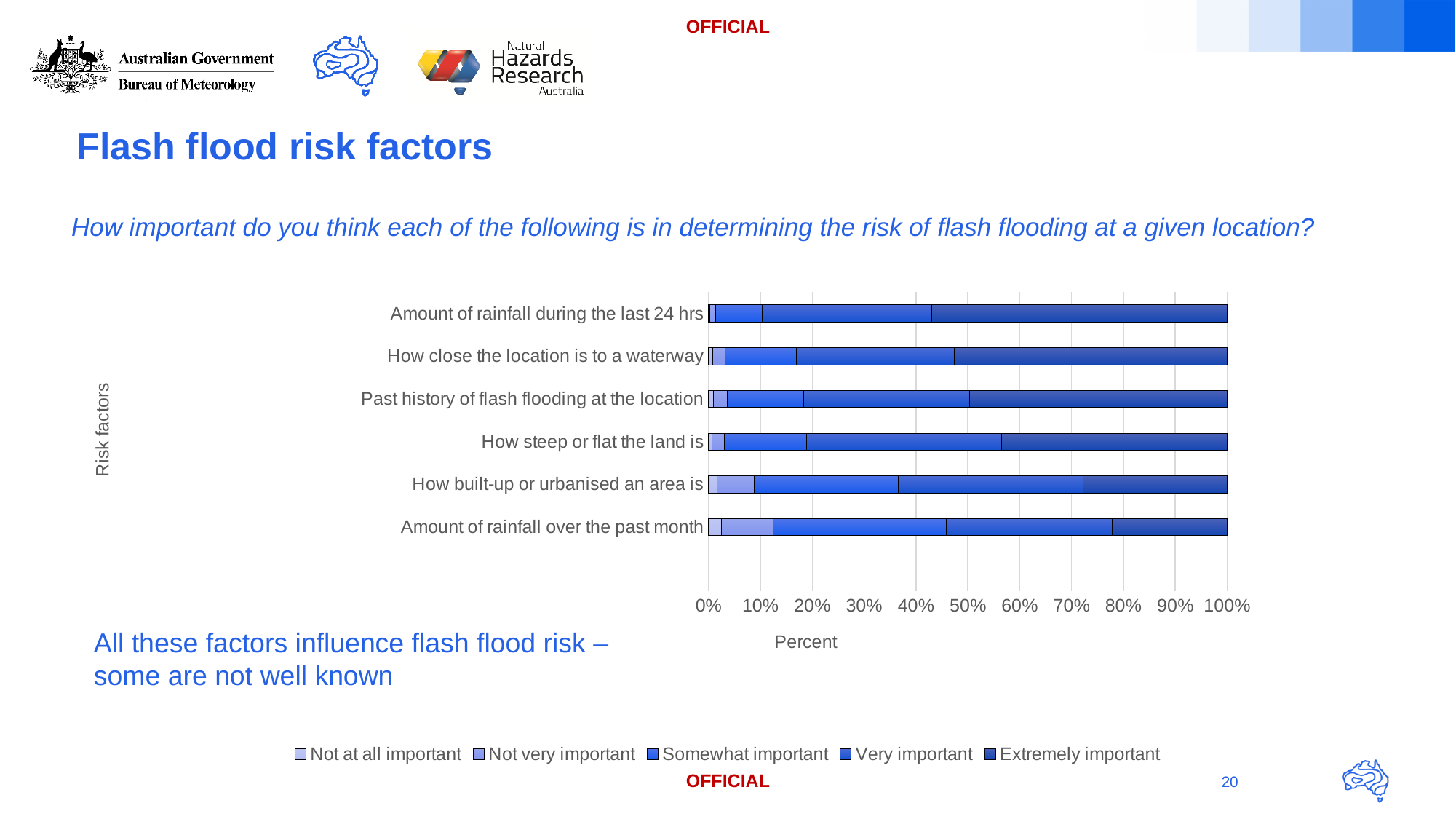
Which risk factor has the smallest 'Extremely important' share? Amount of rainfall over the past month How many risk factors (categories) are plotted in the chart? 6 Which has the larger 'Extremely important' share: 'Amount of rainfall during the last 24 hrs' or 'Amount of rainfall over the past month'? Amount of rainfall during the last 24 hrs What kind of chart is shown on the slide? Stacked bar chart What is the label of the vertical axis of the chart? Risk factors Is the 'Extremely important' share for 'Amount of rainfall over the past month' greater or less than 30%? less How many series does the chart legend list? 5 Which has the larger 'Somewhat important' share: 'How built-up or urbanised an area is' or 'How close the location is to a waterway'? How built-up or urbanised an area is Is the 'Somewhat important' share for 'Amount of rainfall over the past month' greater or less than 20%? greater Is the 'Extremely important' share for 'Amount of rainfall during the last 24 hrs' greater or less than 50%? greater What is the label of the horizontal axis of the chart? Percent